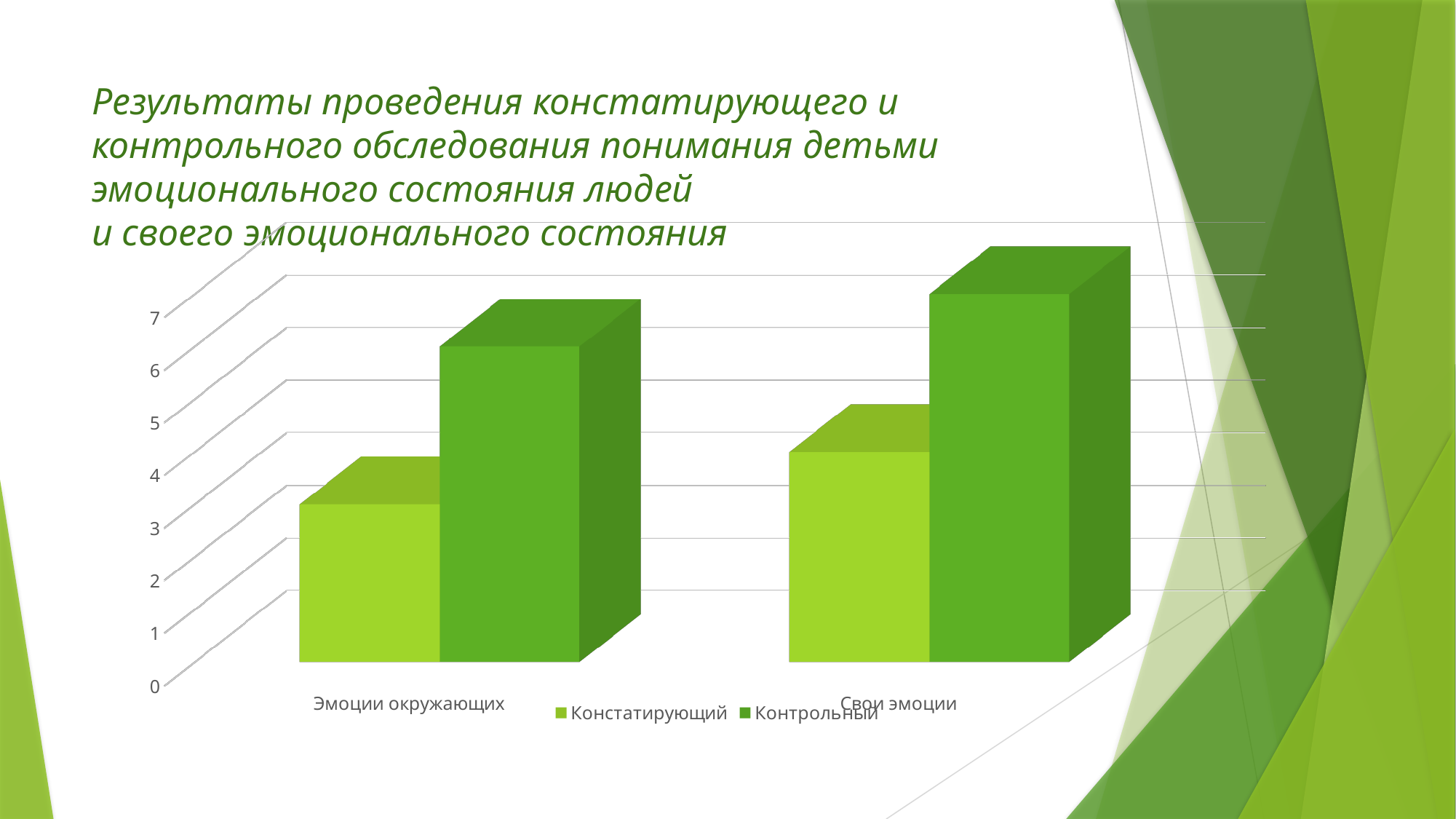
Which series is shown in the lighter green colour in the legend? Констатирующий What kind of chart is shown on the slide? bar chart Which bar is the shortest in the chart? Констатирующий for Эмоции окружающих Is the value for Контрольный in the category Свои эмоции greater or less than 5? greater Is the value for Констатирующий in the category Эмоции окружающих greater or less than 5? less How many series does the chart legend list? 2 Which bar is the tallest in the chart? Контрольный for Свои эмоции Is the value for Контрольный in the category Эмоции окружающих greater or less than 4? greater Does the value for the Констатирующий series rise or fall from Эмоции окружающих to Свои эмоции? rise How many categories are shown on the x axis of the chart? 2 For the category Свои эмоции, which series has the larger value, Констатирующий or Контрольный? Контрольный For the category Эмоции окружающих, which series has the larger value, Констатирующий or Контрольный? Контрольный